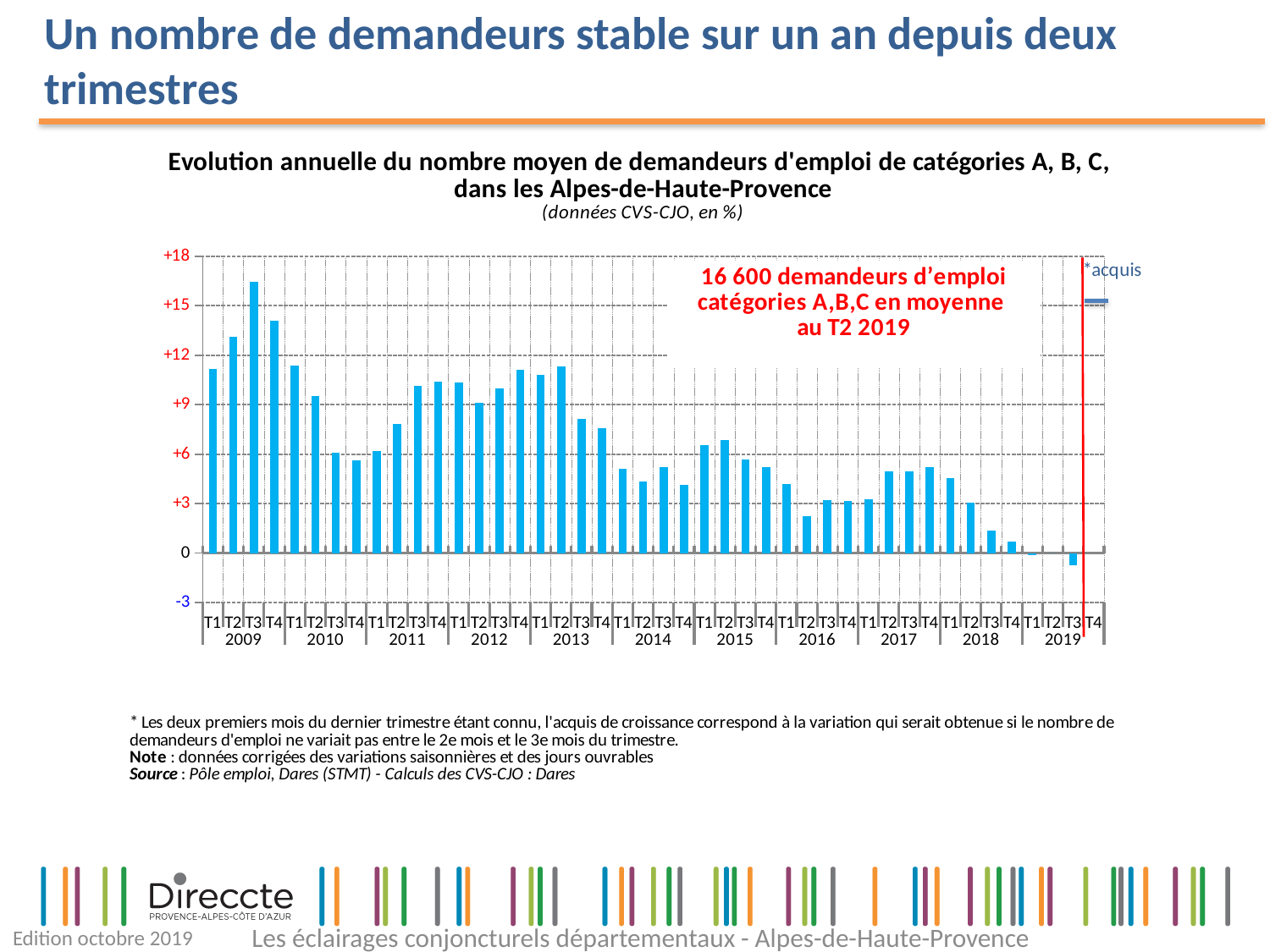
How many years are labelled on the x axis of the chart? 11 Which quarter has the lowest value in the chart? T3 2019 Which quarter has the highest value in the chart? T3 2009 Which is larger, the value for T1 2013 or the value for T1 2014? T1 2013 Is the value for T4 2009 greater or less than +15? less Is the value for T1 2014 greater or less than +6? less Overall, do the values rise or fall from 2009 to 2019? fall Is the value for T3 2009 greater or less than +15? greater Which is larger, the value for T2 2017 or the value for T3 2018? T2 2017 What kind of chart is shown on the slide? bar chart